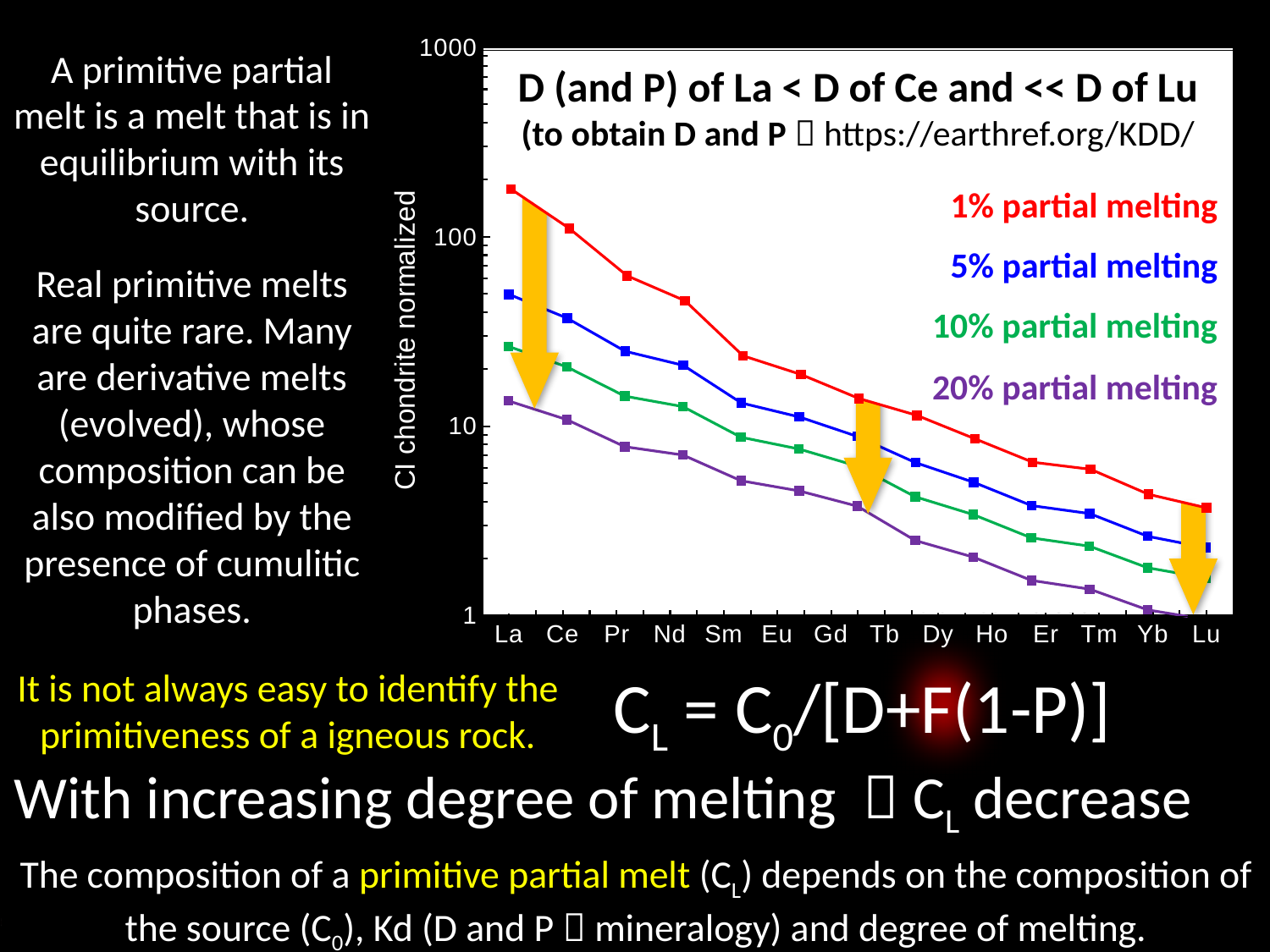
Which series has the lowest values across the chart? 20% partial melting How many series does the chart's legend list? 4 At La, which is larger: the 1% partial melting value or the 20% partial melting value? 1% partial melting How many categories are shown along the x axis of the chart? 14 Is the value for La in the 1% partial melting series greater or less than 100? greater Is the value for La in the 5% partial melting series greater or less than 100? less Do the values of the 1% partial melting series rise or fall from La to Lu? fall What kind of chart is shown on the slide? line chart Is the value for Lu in the 1% partial melting series greater or less than 10? less Which series has the highest values across the chart? 1% partial melting What is the label of the chart's y axis? CI chondrite normalized